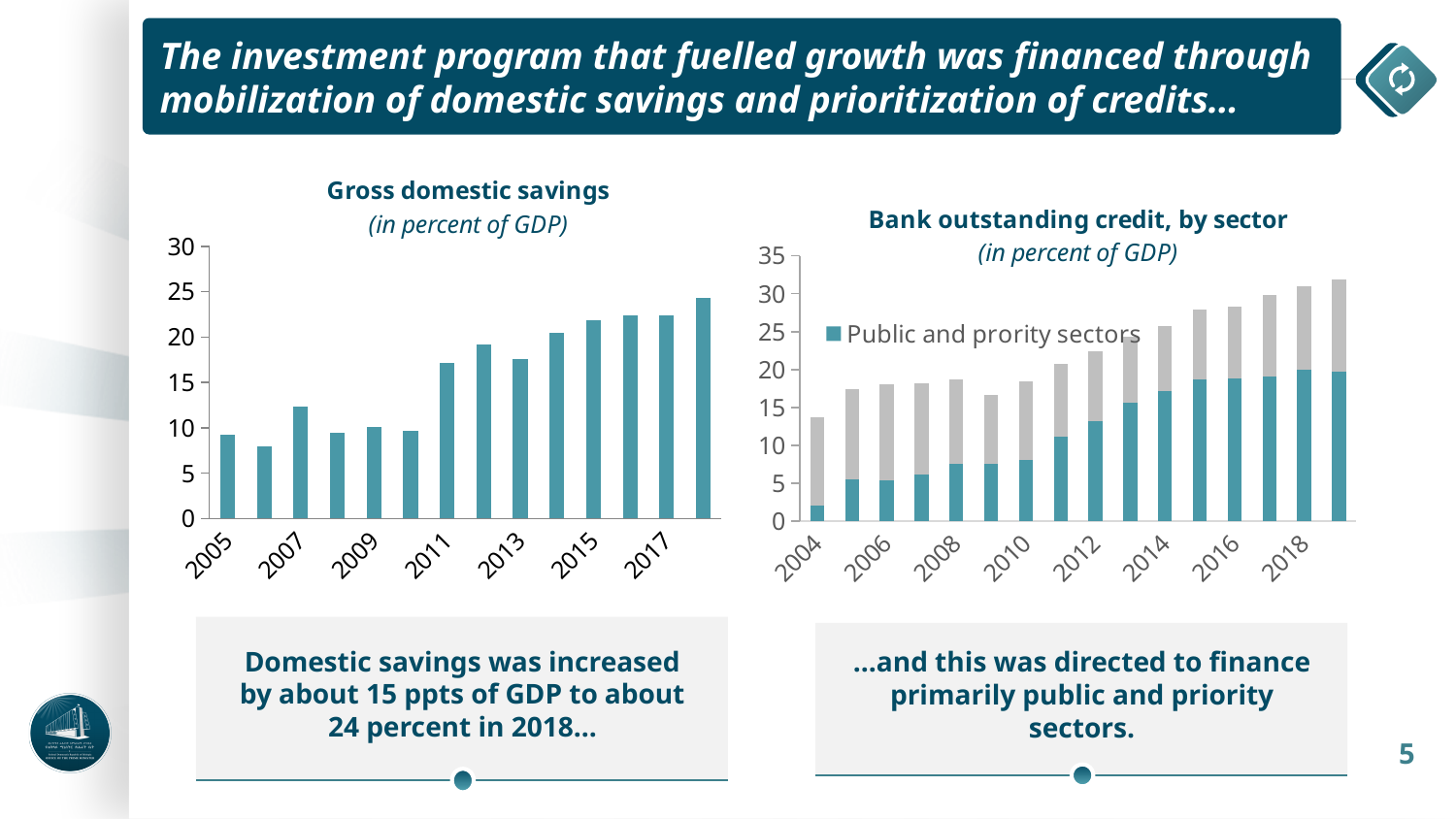
What kind of chart is the 'Gross domestic savings' chart on the left? bar chart In the 'Bank outstanding credit, by sector' chart, what unit is given in the subtitle under the chart title? in percent of GDP In the 'Gross domestic savings' chart, which year has the highest value? 2018 In the 'Bank outstanding credit, by sector' chart, is the total for 2019 greater or less than 30? greater In the 'Gross domestic savings' chart, which year has the lowest value? 2006 In the 'Gross domestic savings' chart, is the value for 2018 greater or less than 20? greater What kind of chart is the 'Bank outstanding credit, by sector' chart on the right? stacked bar chart How many bars are plotted in the 'Gross domestic savings' chart? 14 In the 'Gross domestic savings' chart, is the value for 2005 greater or less than 10? less In the 'Gross domestic savings' chart, do the values generally rise or fall from 2011 to 2018? rise In the 'Gross domestic savings' chart, which is larger, the value for 2007 or the value for 2008? 2007 In the 'Bank outstanding credit, by sector' chart, which year has the lowest total bar? 2004